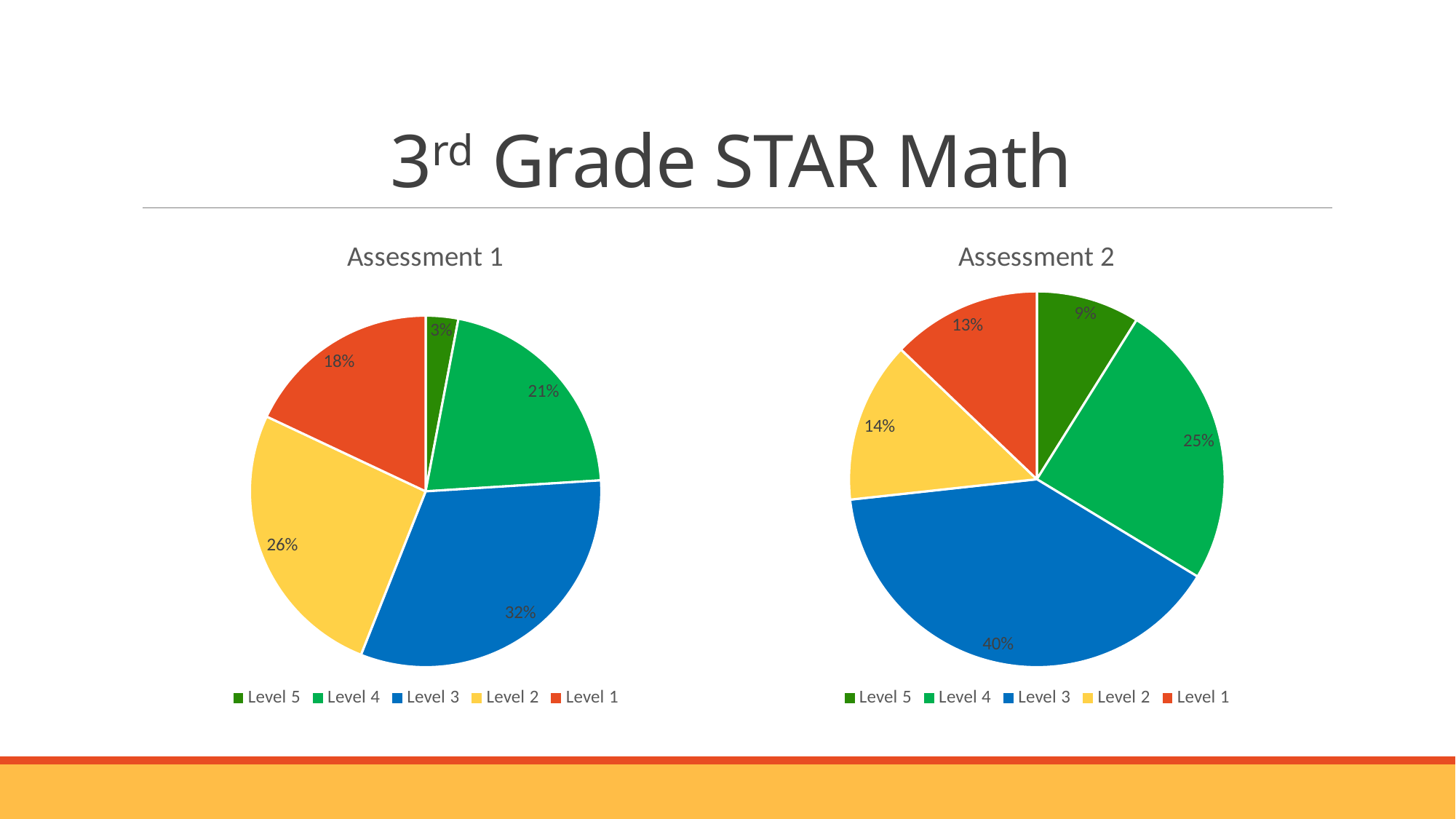
How many slices does the Assessment 1 pie chart have? 5 In the Assessment 2 chart, what percentage is shown for Level 5? 9% In the Assessment 1 chart, which level has the smallest share? Level 5 In the Assessment 1 chart, what percentage is shown for Level 1? 18% In the Assessment 1 chart, which colour represents Level 2? Yellow In the Assessment 2 chart, which is larger, the Level 4 share or the Level 1 share? Level 4 What type of chart is used for Assessment 2? Pie chart In the Assessment 2 chart, which level has the smallest share? Level 5 In the Assessment 1 chart, which level has the largest share? Level 3 In the Assessment 1 chart, what percentage is shown for Level 3? 32% What is the difference between the Level 3 share in Assessment 2 and the Level 3 share in Assessment 1? 8% In the Assessment 2 chart, what percentage is shown for Level 2? 14%